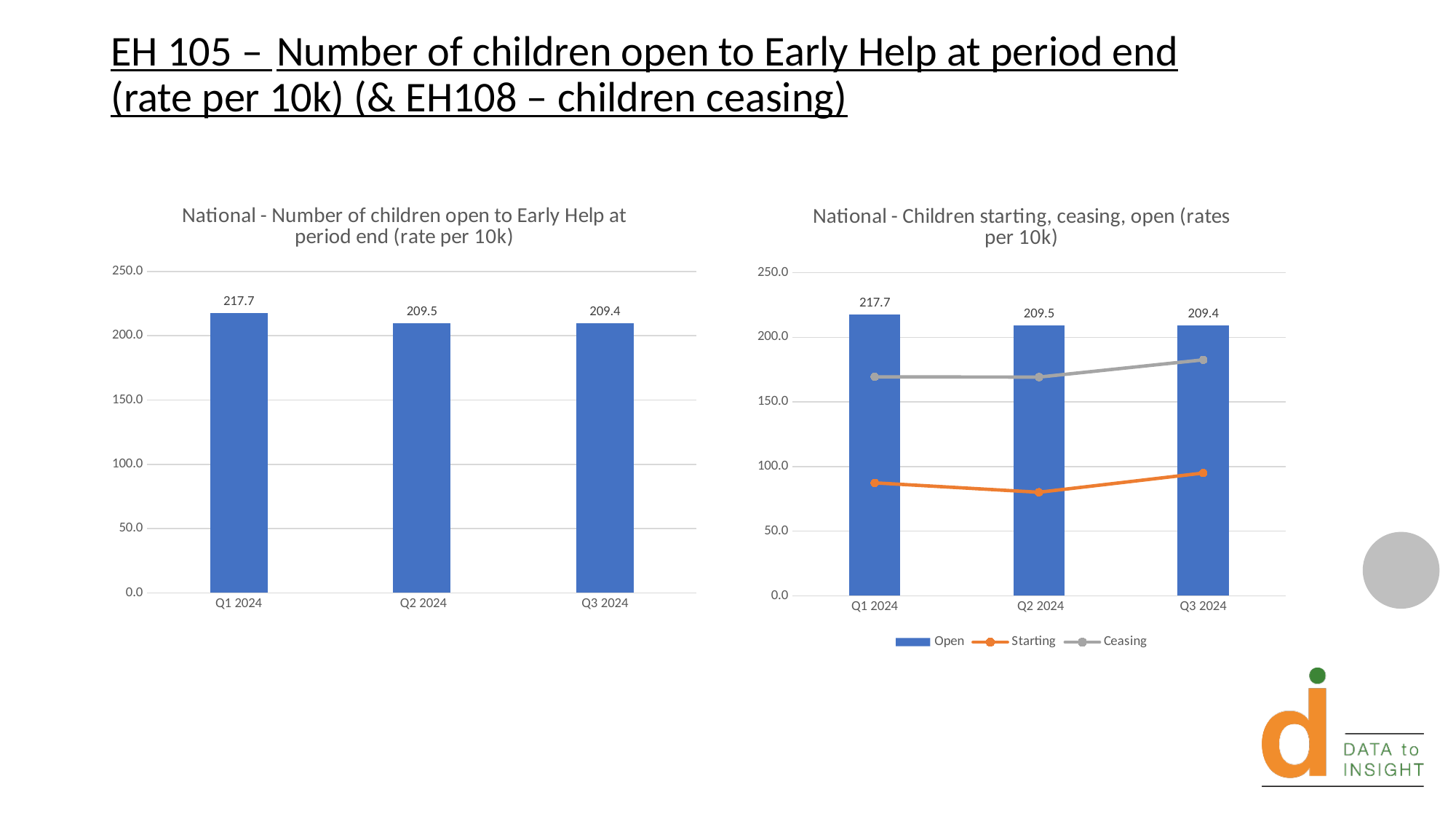
In the right chart, is the Starting value for Q2 2024 greater or less than 100.0? less In the right chart, does the Ceasing line rise or fall from Q1 2024 to Q3 2024? Rises In the left chart, what is the value for Q2 2024? 209.5 In the right chart, is the Ceasing value for Q3 2024 greater or less than 150.0? greater In the left chart, 'National - Number of children open to Early Help at period end (rate per 10k)', what is the value for Q1 2024? 217.7 In the left chart, what is the difference between the Q1 2024 and Q2 2024 values? 8.2 How many series does the legend of the right chart list? 3 In the right chart, 'National - Children starting, ceasing, open (rates per 10k)', what is the Open value for Q3 2024? 209.4 How many quarters are shown on the x axis of the left chart? 3 What kind of chart is the left chart? Bar chart In the right chart, is the Open value for Q1 2024 larger than the Open value for Q3 2024? Yes, Q1 2024 In the left chart, which quarter has the highest value? Q1 2024